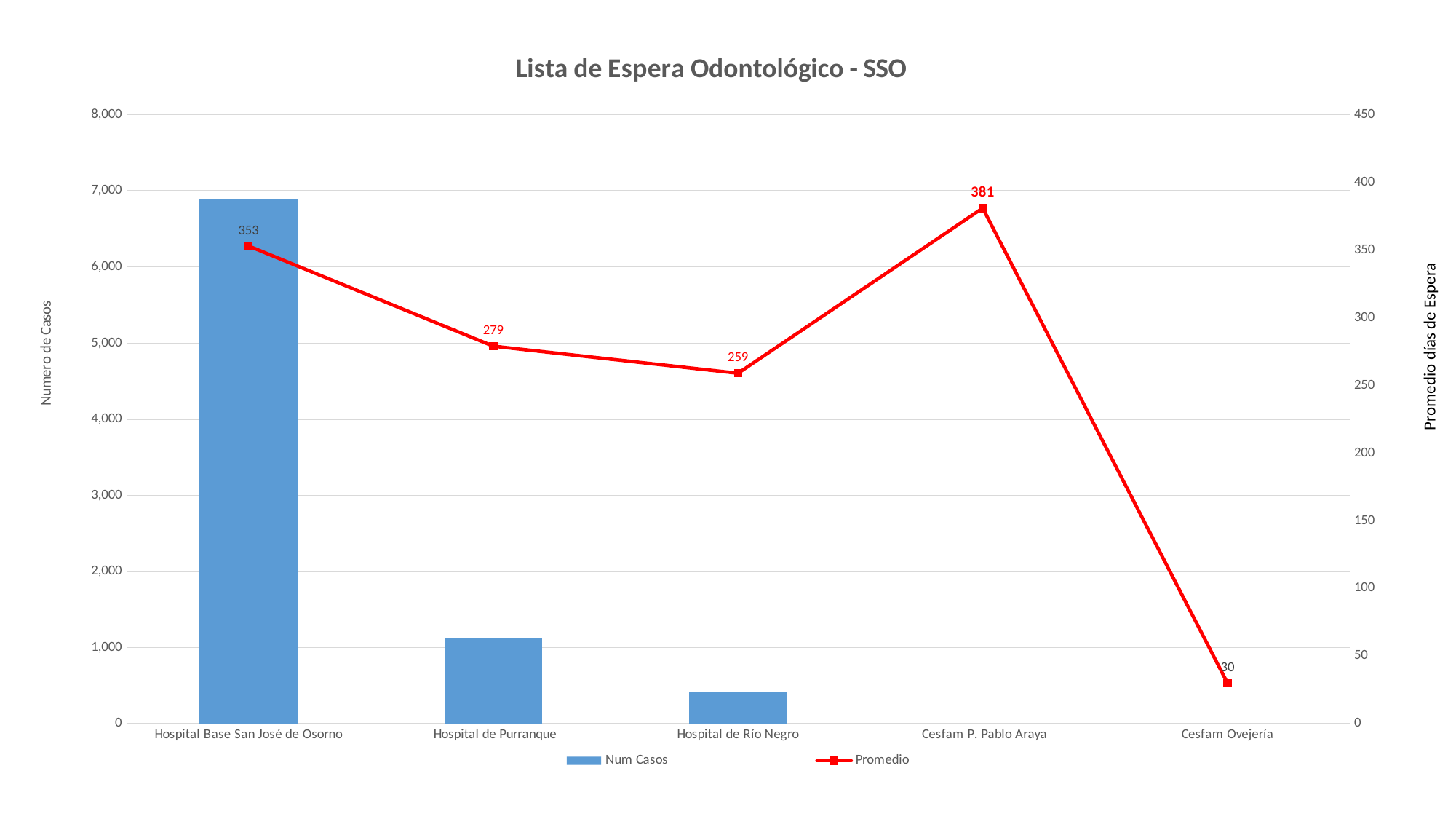
What is the Promedio value for Cesfam Ovejería? 30 What is the Promedio value for Cesfam P. Pablo Araya? 381 Which category has the lowest Promedio value? Cesfam Ovejería How many categories are shown on the x axis? 5 Is the Num Casos value for Hospital Base San José de Osorno greater or less than 6,000? greater How many series does the legend list? 2 What is the Promedio value for Hospital de Purranque? 279 What is the difference between the Promedio values for Cesfam P. Pablo Araya and Hospital Base San José de Osorno? 28 Is the Num Casos value for Hospital de Río Negro greater or less than 1,000? less Which category has the highest Promedio value? Cesfam P. Pablo Araya What is the Promedio value for Hospital Base San José de Osorno? 353 Which has a larger Promedio value, Hospital de Purranque or Hospital de Río Negro? Hospital de Purranque